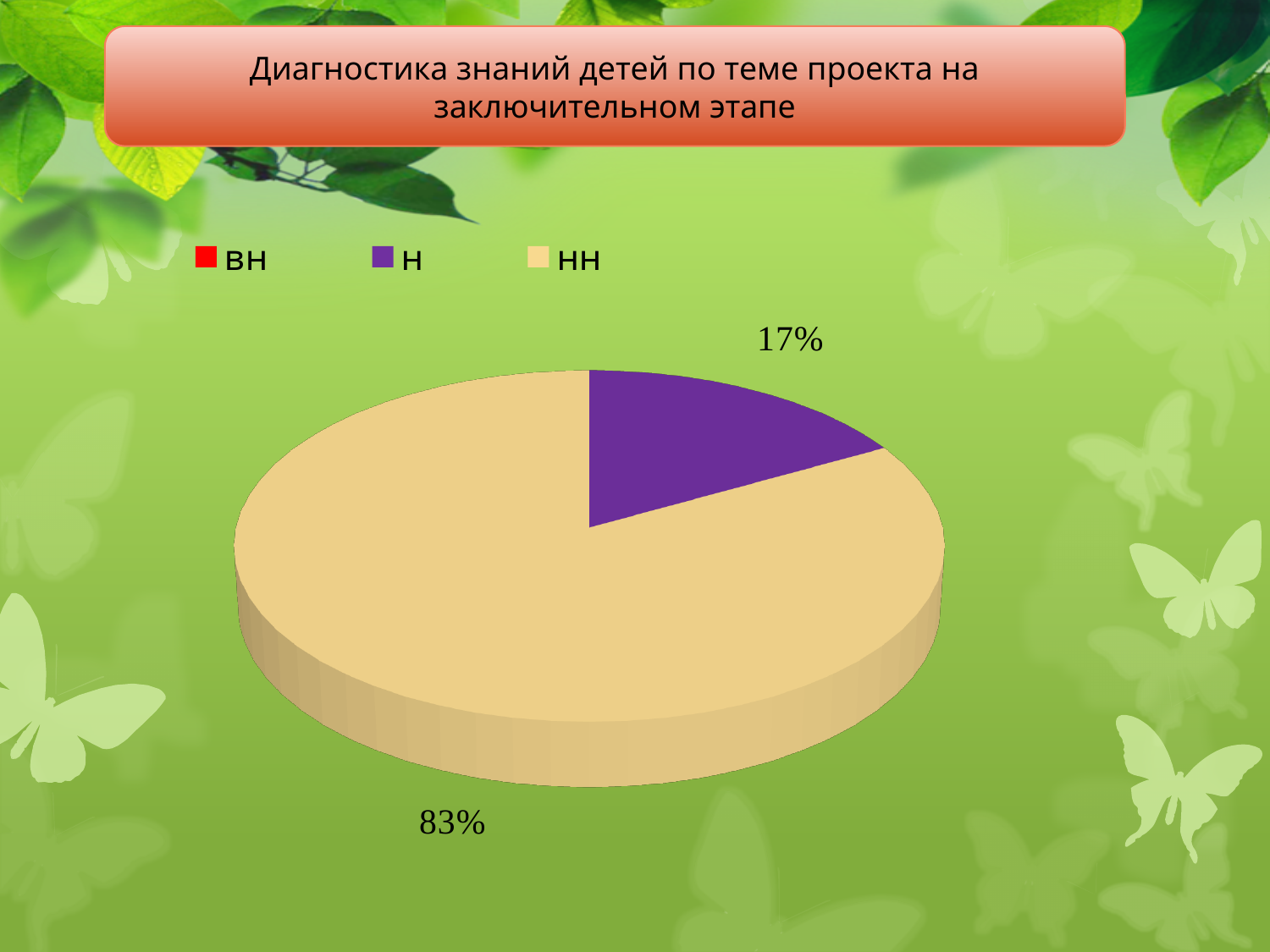
Which category has the largest slice in the pie chart? НН What kind of chart is shown on the slide? Pie chart How many entries does the legend of the chart list? 3 How many slices with data labels are visible in the pie chart? 2 Is the share of the НН slice greater or less than 50%? greater What percentage does the Н slice represent in the pie chart? 17% What colour is the Н slice in the pie chart? Purple What percentage does the НН slice represent in the pie chart? 83% What is the title shown above the chart on the slide? Диагностика знаний детей по теме проекта на заключительном этапе By how many percentage points does the НН slice exceed the Н slice? 66 percentage points Which is larger in the pie chart, the Н slice or the НН slice? НН